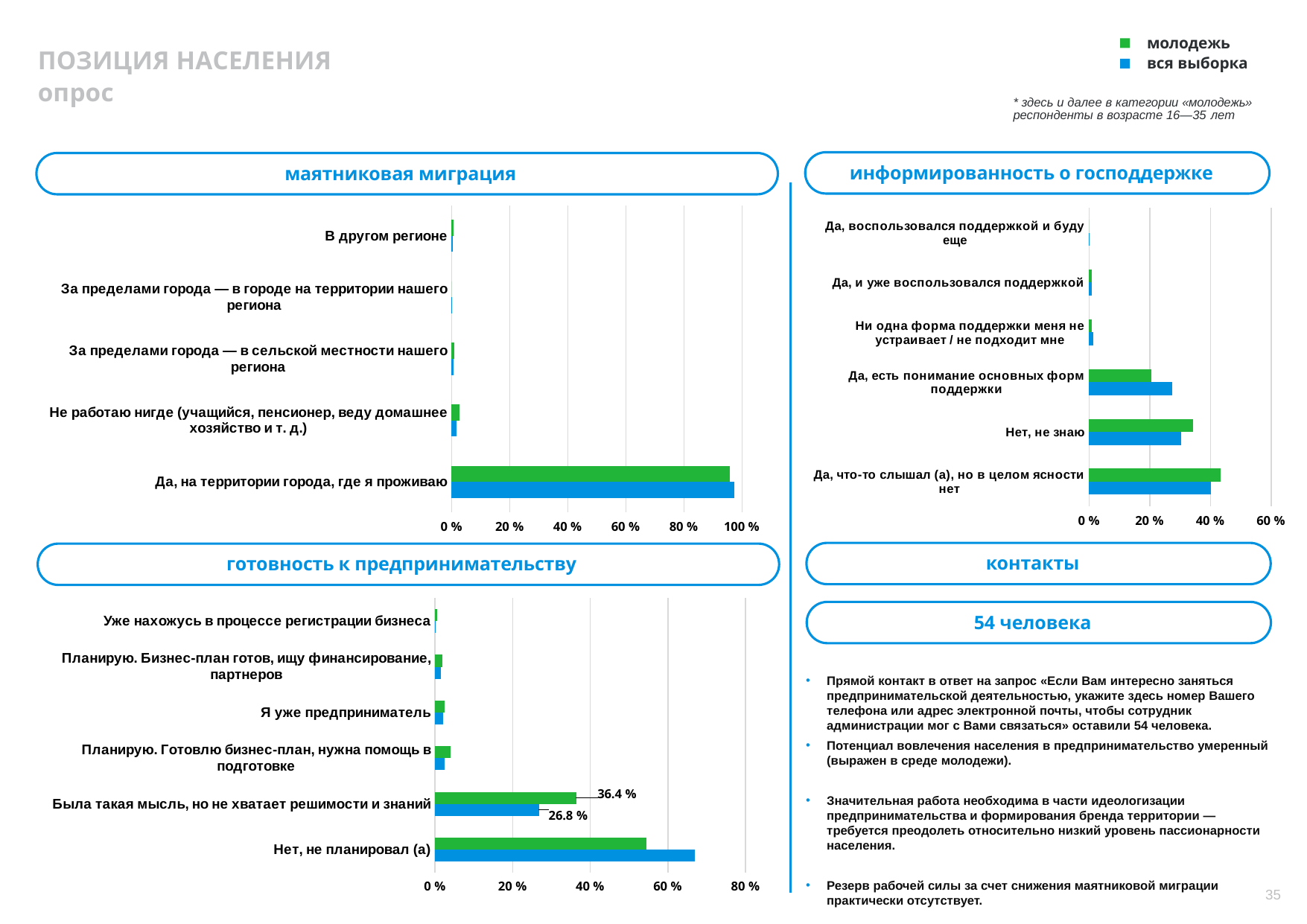
How many categories are shown in the chart 'информированность о господдержке'? 6 In the chart 'готовность к предпринимательству', what is the value for вся выборка for 'Была такая мысль, но не хватает решимости и знаний'? 26.8 % How many categories are shown in the chart 'маятниковая миграция'? 5 In the chart 'маятниковая миграция', which category has the highest values? Да, на территории города, где я проживаю In the chart 'готовность к предпринимательству', is the value for вся выборка for 'Нет, не планировал (а)' greater or less than 60 %? greater What kind of chart is 'готовность к предпринимательству'? bar chart In the chart 'информированность о господдержке', which category has the highest value for молодежь? Да, что-то слышал (а), но в целом ясности нет In the chart 'готовность к предпринимательству', what is the difference between the молодежь and вся выборка values for 'Была такая мысль, но не хватает решимости и знаний'? 9.6 % How many series does the legend at the top right of the slide list? 2 In the chart 'готовность к предпринимательству', what is the value for молодежь for 'Была такая мысль, но не хватает решимости и знаний'? 36.4 % In the chart 'маятниковая миграция', is the value for вся выборка for 'Да, на территории города, где я проживаю' greater or less than 80 %? greater In the chart 'готовность к предпринимательству', for 'Была такая мысль, но не хватает решимости и знаний', which series has the larger value: молодежь or вся выборка? молодежь